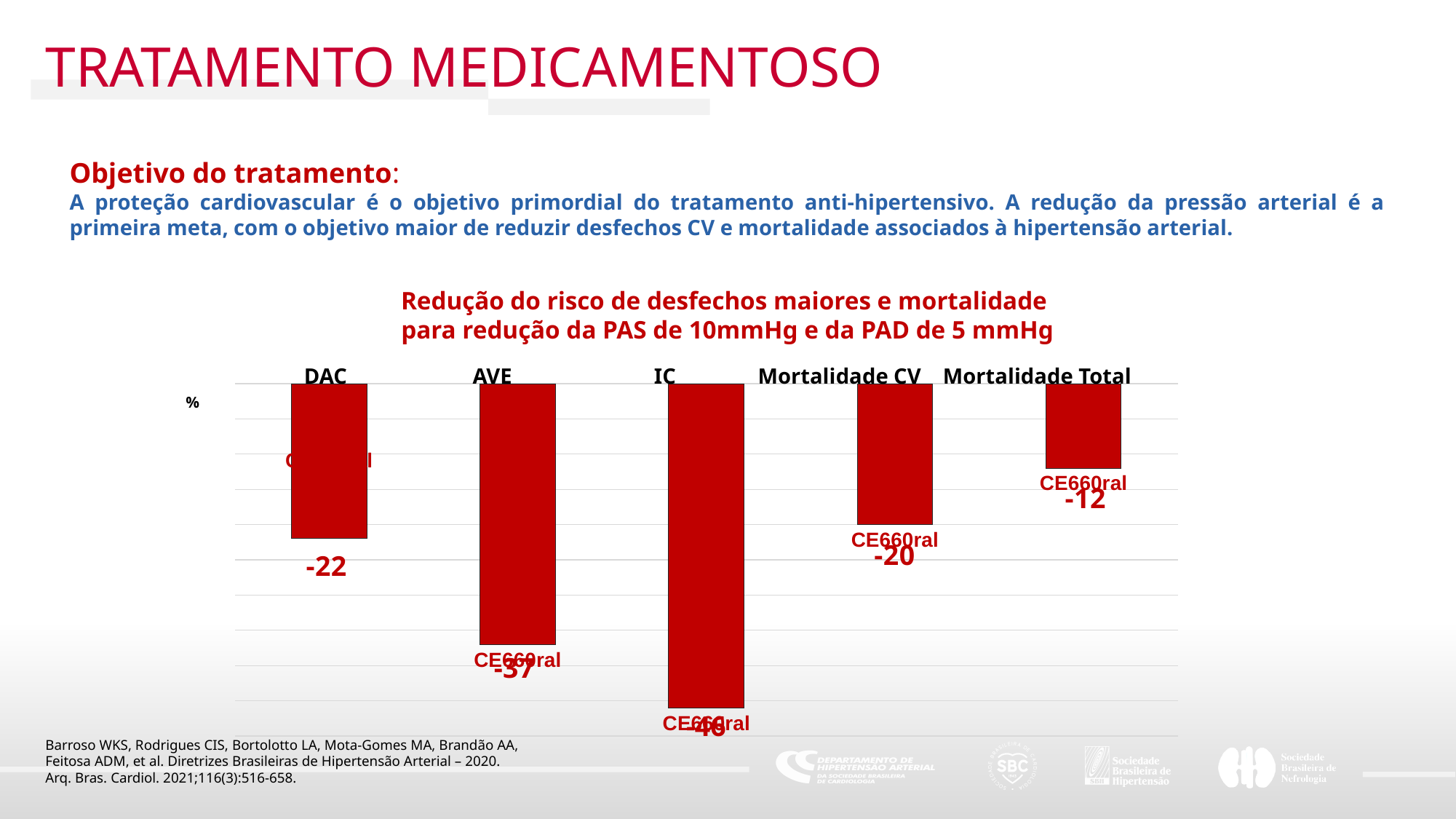
Which category has the shortest bar (smallest risk reduction)? Mortalidade Total Which category has the longest bar (largest risk reduction)? IC What colour are the bars in the chart? Red What is the value shown for Mortalidade CV? -20 What is the value shown for DAC? -22 Which bar is longer, AVE or DAC? AVE What kind of chart is shown on the slide? Bar chart What is the value shown for AVE? -37 What is the value shown for Mortalidade Total? -12 What is the difference between the values for AVE and DAC? 15 How many categories are shown in the chart? 5 What is the difference between the values for Mortalidade CV and Mortalidade Total? 8